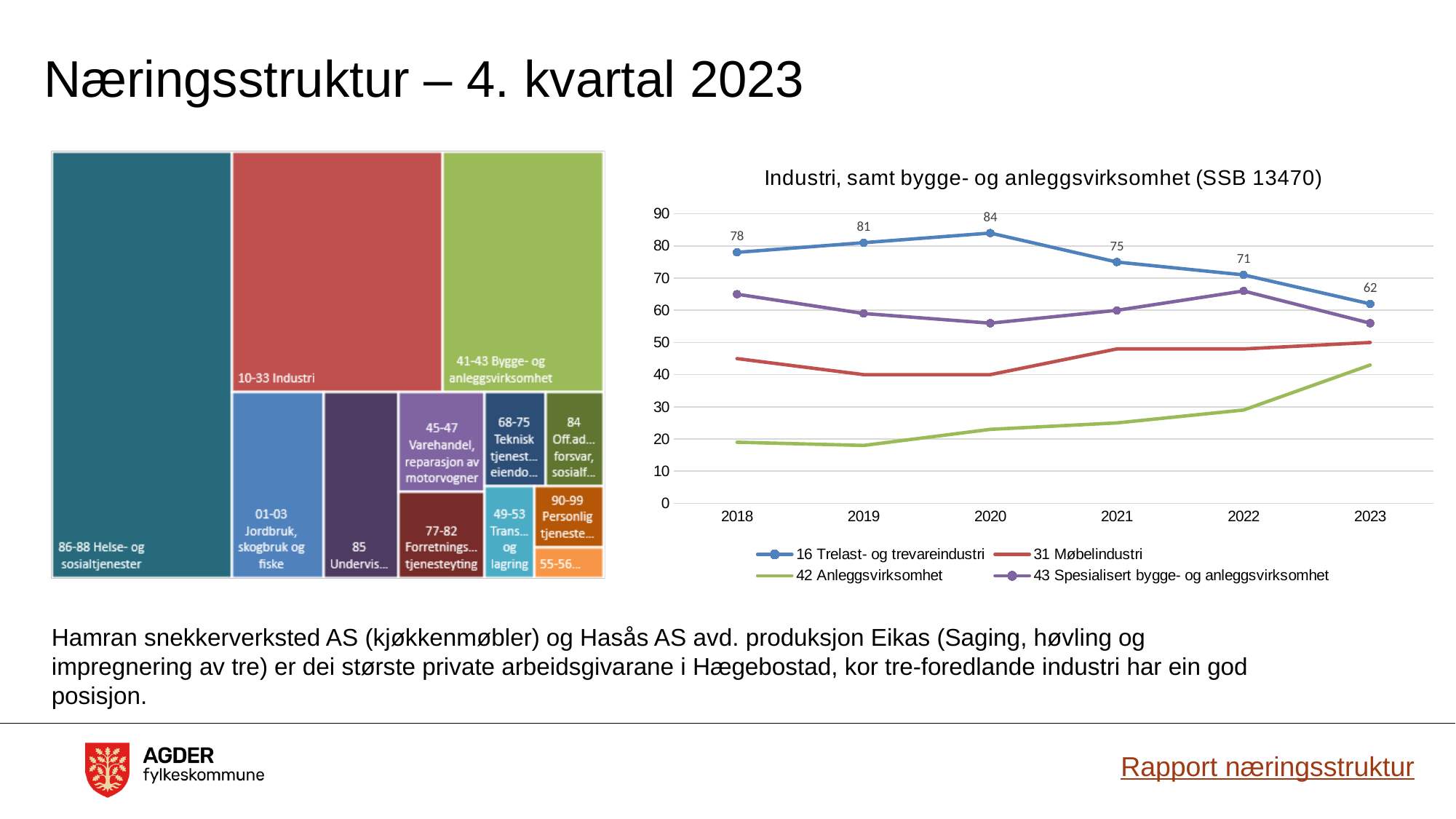
On the line chart on the right, what is the value for '16 Trelast- og trevareindustri' in 2023? 62 On the line chart on the right, how many series does the legend list? 4 On the line chart on the right, in which year is '16 Trelast- og trevareindustri' at its lowest value? 2023 On the line chart on the right, does the value for '16 Trelast- og trevareindustri' rise or fall from 2020 to 2023? fall On the line chart on the right, in which year does '16 Trelast- og trevareindustri' reach its highest value? 2020 On the line chart on the right, what is the difference between the 2020 and 2023 values for '16 Trelast- og trevareindustri'? 22 On the line chart titled 'Industri, samt bygge- og anleggsvirksomhet (SSB 13470)', what is the value for '16 Trelast- og trevareindustri' in 2020? 84 On the line chart on the right, is the value for '43 Spesialisert bygge- og anleggsvirksomhet' in 2022 greater or less than 60? greater On the line chart on the right, how many years are shown on the x axis? 6 On the line chart on the right, is the value for '42 Anleggsvirksomhet' in 2021 greater or less than 30? less On the treemap on the left, which category occupies the largest area? 86-88 Helse- og sosialtjenester On the line chart on the right, is the value for '16 Trelast- og trevareindustri' higher in 2018 or in 2019? 2019